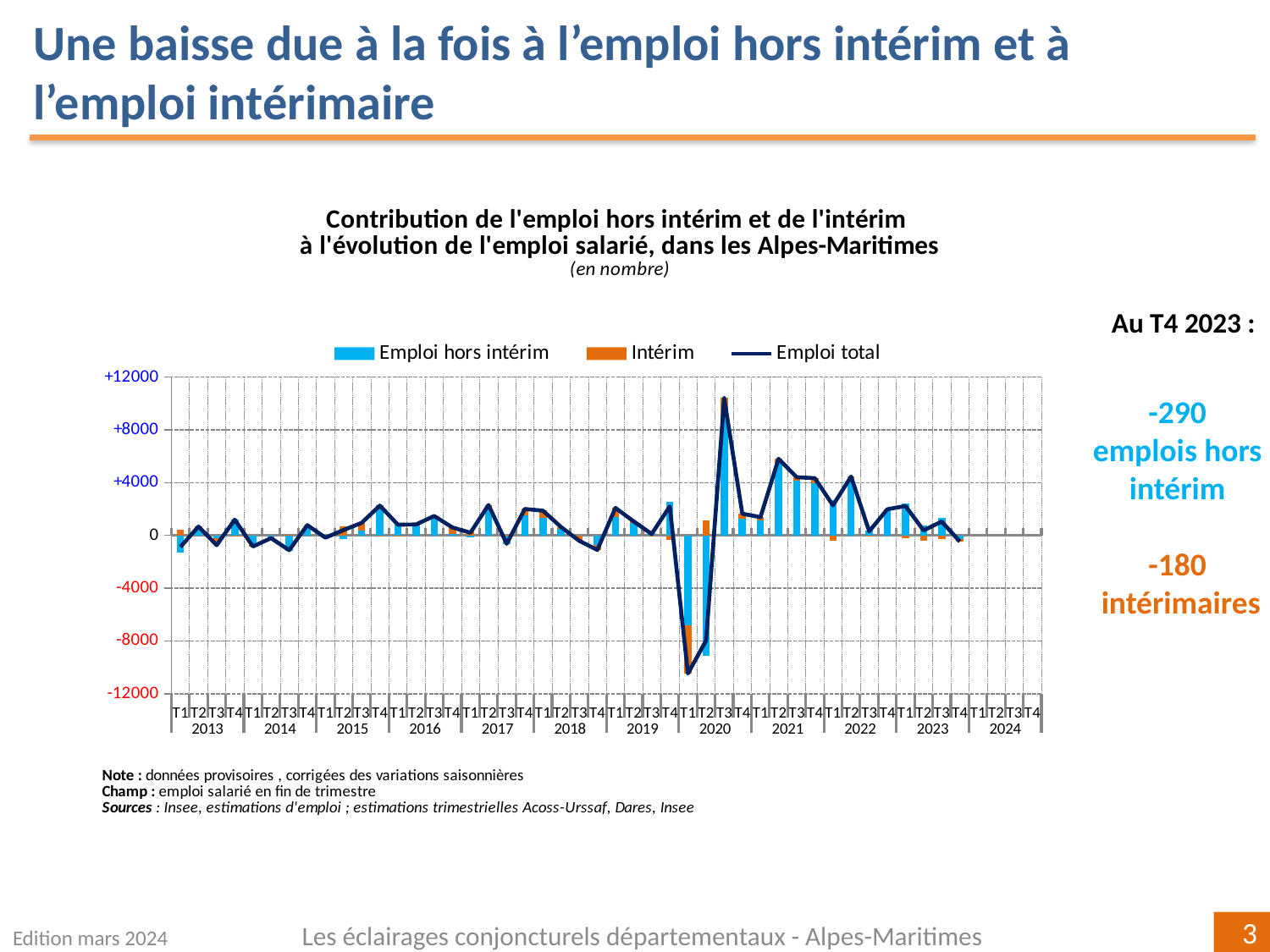
How many years are labelled along the x axis? 12 According to the slide, what is the value for Emploi hors intérim at T4 2023? -290 According to the slide, what is the value for Intérim (intérimaires) at T4 2023? -180 Is the value of Emploi total at T3 2020 greater or less than +8000? greater How many series does the legend list? 3 What are the three series named in the legend? Emploi hors intérim, Intérim, Emploi total What kind of chart is shown on the slide? A combined bar and line chart In which quarter does Emploi total reach its highest value? T3 2020 Is the value of Emploi hors intérim at T2 2021 greater or less than +4000? greater Which is larger for Emploi hors intérim: the value at T3 2020 or the value at T2 2021? T3 2020 In which quarter does Emploi total reach its lowest value? T1 2020